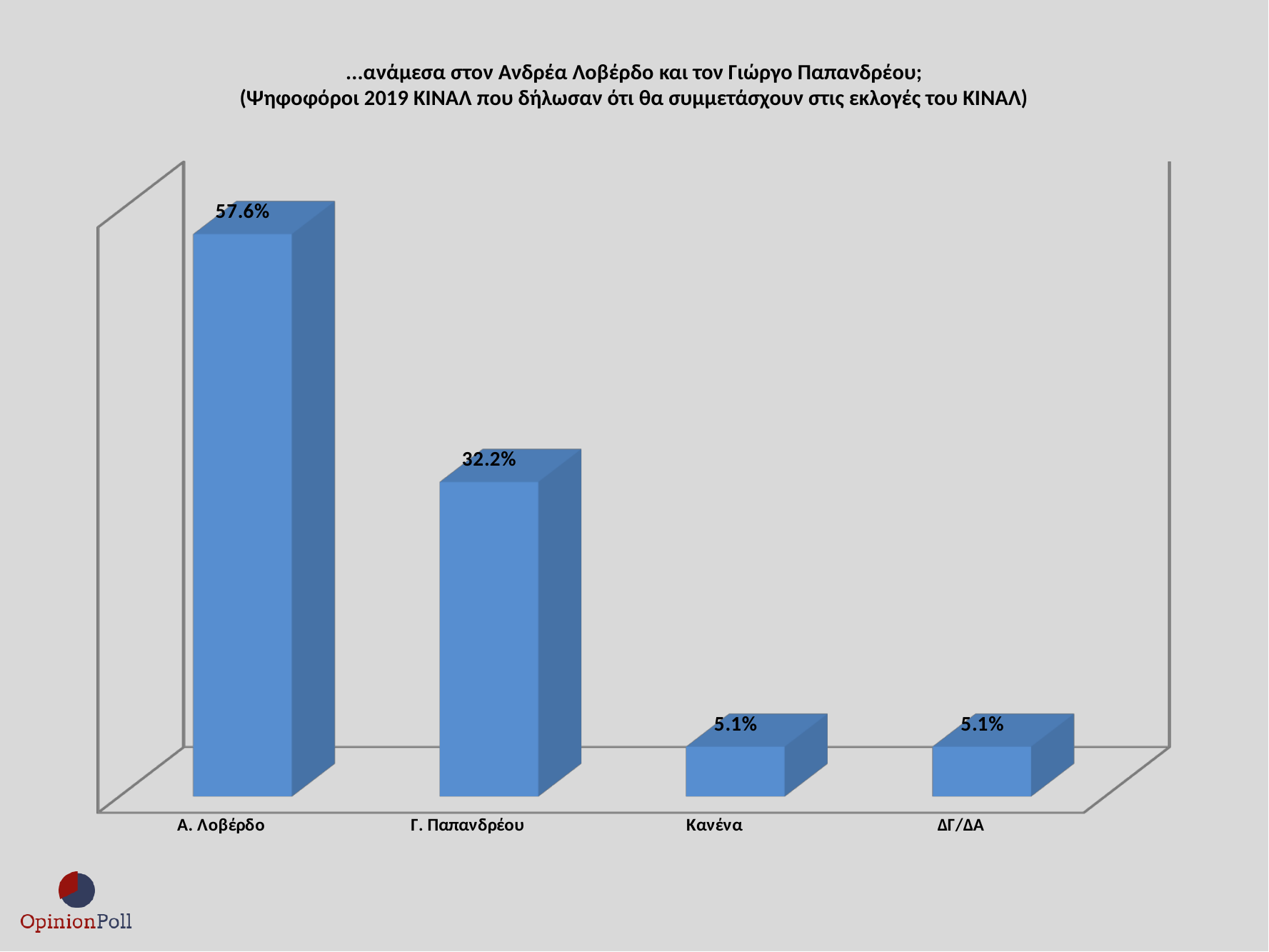
What is the value for Α. Λοβέρδο? 57.6% What is the difference between the values for Α. Λοβέρδο and Γ. Παπανδρέου? 25.4% What colour are the bars in the chart? Blue Do the values rise or fall from left to right across the categories? Fall What is the value for Κανένα? 5.1% How many categories are shown on the chart? 4 Which category has the highest value? Α. Λοβέρδο What is the difference between the values for Γ. Παπανδρέου and Κανένα? 27.1% What is the value for ΔΓ/ΔΑ? 5.1% What kind of chart is shown on the slide? Bar chart Which is larger, the value for Γ. Παπανδρέου or the value for ΔΓ/ΔΑ? Γ. Παπανδρέου What is the value for Γ. Παπανδρέου? 32.2%